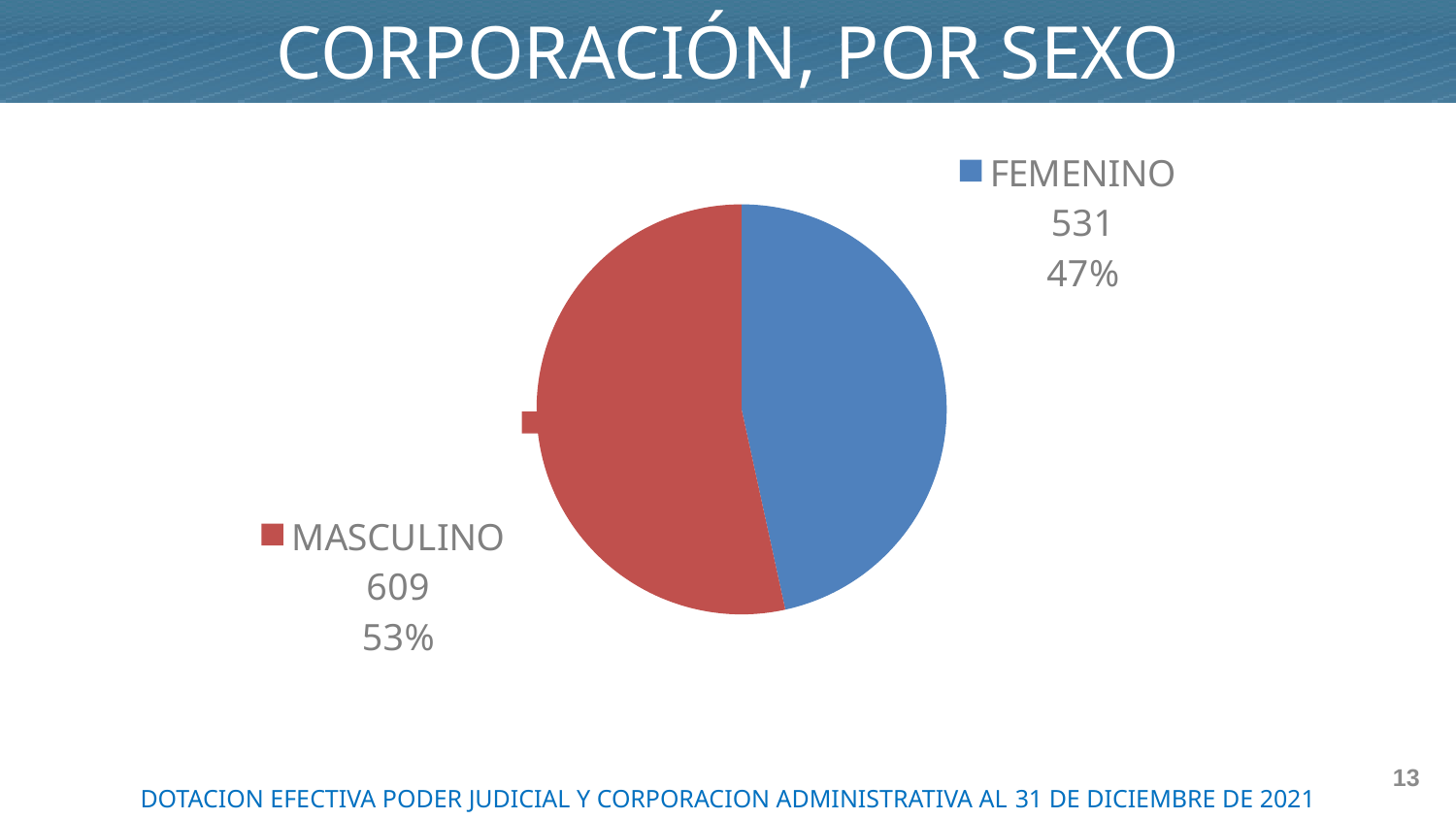
What is the value for MASCULINO? 609 What is the difference between the MASCULINO and FEMENINO values? 78 What kind of chart is shown on the slide? Pie chart What colour is the FEMENINO slice? Blue What percentage share does MASCULINO have? 53% Which category has the largest slice? MASCULINO What is the value for FEMENINO? 531 What is the total of the MASCULINO and FEMENINO values? 1140 What percentage share does FEMENINO have? 47% Which category has the smallest slice? FEMENINO How many categories does the pie chart show? 2 Which is larger, MASCULINO or FEMENINO? MASCULINO